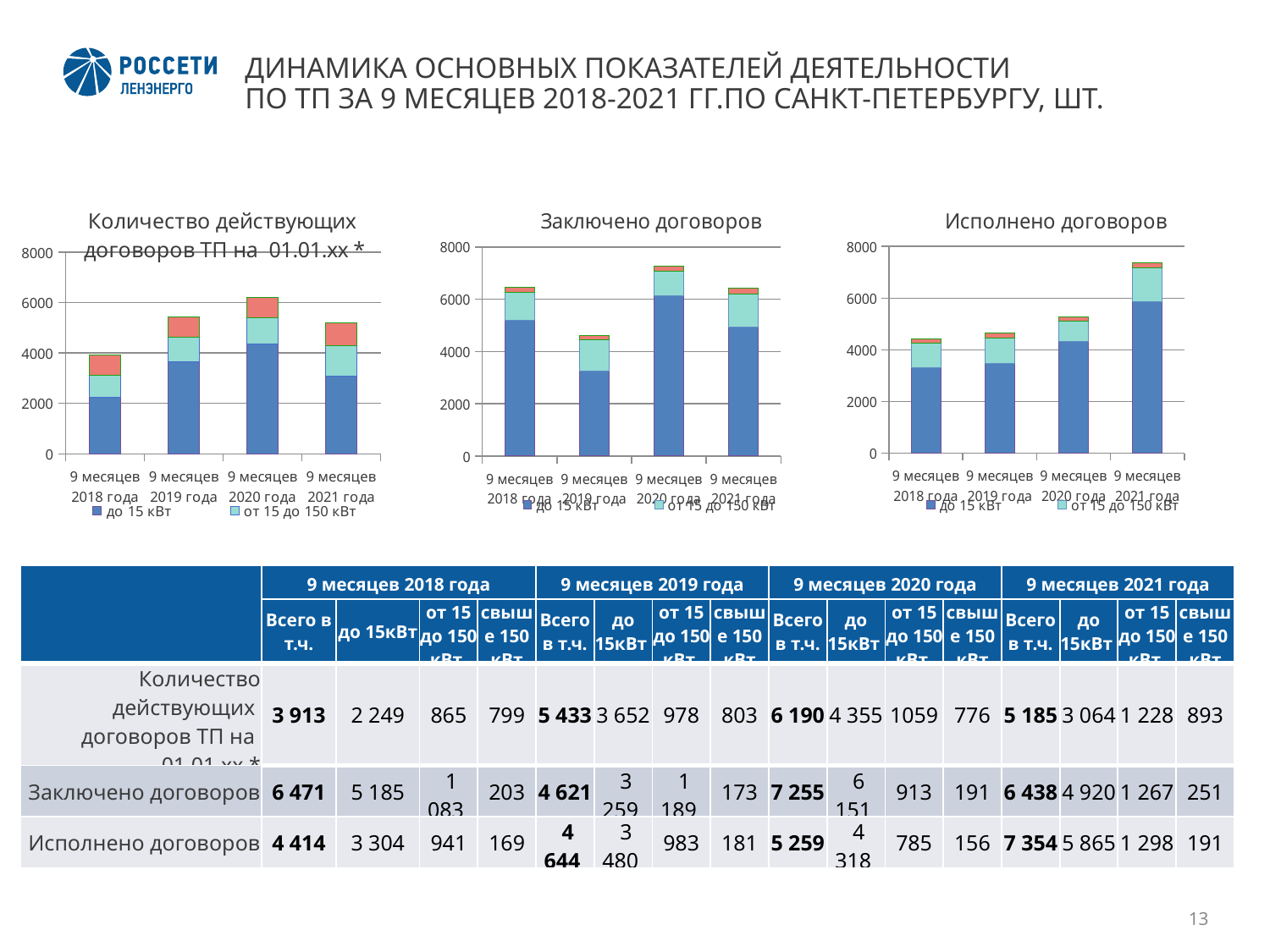
In the 'Заключено договоров' chart, which period has the highest total? 9 месяцев 2020 года In the 'Заключено договоров' chart, is the total for 9 месяцев 2020 года greater or less than 6000? greater In the 'Исполнено договоров' chart, is the total for 9 месяцев 2021 года greater or less than 6000? greater In the 'Количество действующих договоров ТП на 01.01.xx *' chart, is the total for 9 месяцев 2018 года greater or less than 6000? less In the 'Количество действующих договоров ТП на 01.01.xx *' chart, which period has the highest total? 9 месяцев 2020 года In the 'Исполнено договоров' chart, do the totals rise or fall from 2018 to 2021? rise In the 'Заключено договоров' chart, which period has the lowest total? 9 месяцев 2019 года In the 'Исполнено договоров' chart, which period has the lowest total? 9 месяцев 2018 года How many categories (periods) are shown on the x axis of the 'Заключено договоров' chart? 4 In the 'Исполнено договоров' chart, which period has the highest total? 9 месяцев 2021 года What kind of chart is the 'Исполнено договоров' chart? bar chart